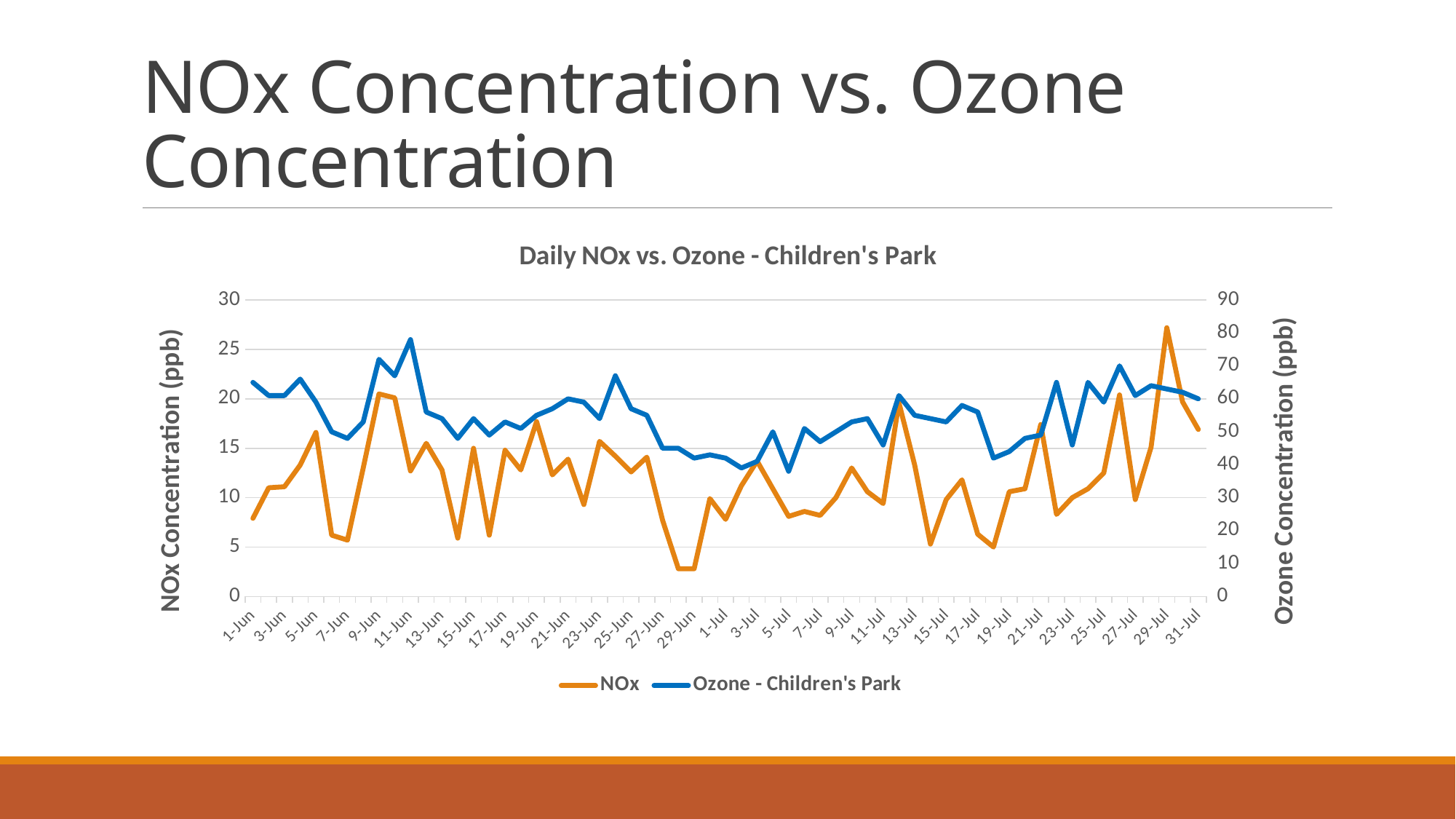
What kind of chart is shown on the slide? Line chart What is the title of the chart? Daily NOx vs. Ozone - Children's Park Is the NOx value on 28-Jun greater or less than 5? less How many series does the legend list? 2 Is the Ozone - Children's Park value on 11-Jun greater or less than 70? greater On which date does the NOx series reach its highest value? 29-Jul What is the label of the right-hand vertical axis? Ozone Concentration (ppb) On which date does the Ozone - Children's Park series reach its highest value? 11-Jun Is the NOx value on 1-Jun greater or less than 10? less Which is larger, the NOx value on 29-Jul or the NOx value on 1-Jun? 29-Jul